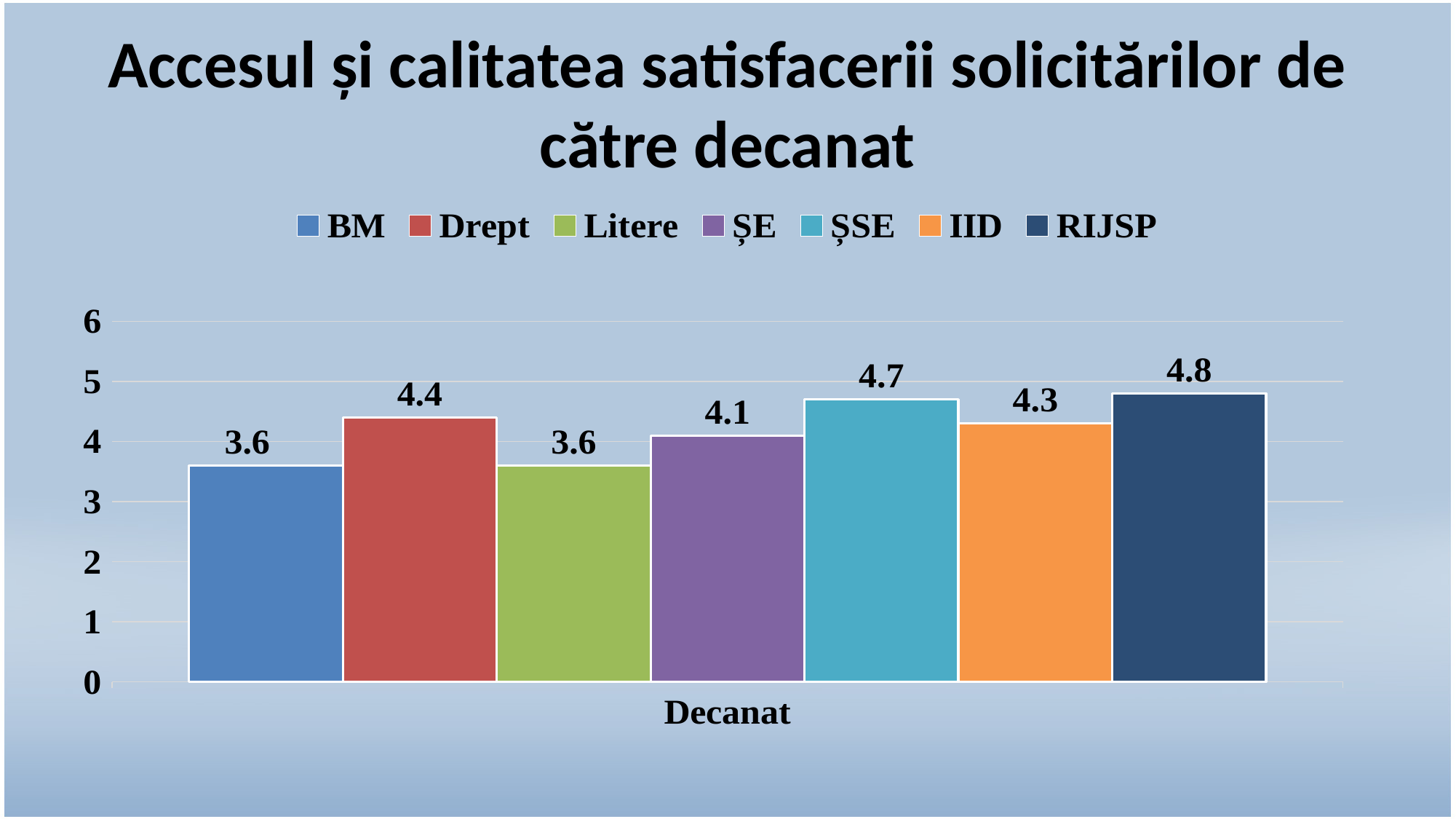
Which series has the highest value? RIJSP Which is larger, the value for Drept or the value for IID? Drept Is the value for ȘE greater or less than 4? greater What is the label on the x axis? Decanat What is the value for ȘSE? 4.7 What kind of chart is shown on the slide? bar chart What is the difference between the values for RIJSP and BM? 1.2 What is the value for Drept? 4.4 What is the value for IID? 4.3 Which two series share the same value of 3.6? BM and Litere How many series does the legend list? 7 What is the difference between the values for ȘSE and ȘE? 0.6